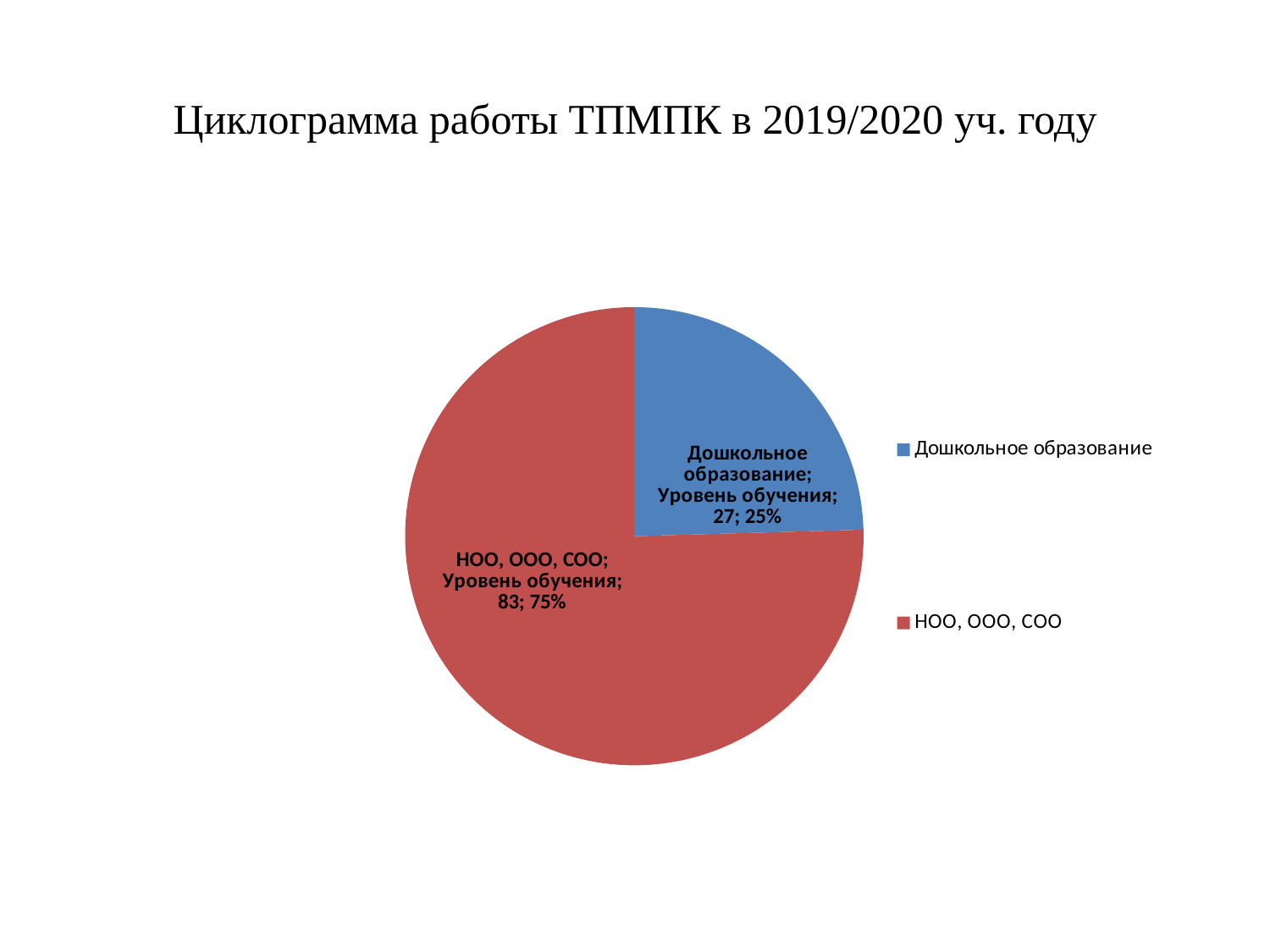
What kind of chart is shown on the slide? pie chart Which category has the largest slice? НОО, ООО, СОО What is the value for НОО, ООО, СОО? 83 What share of the pie does Дошкольное образование take? 25% What colour is the slice for Дошкольное образование? blue What is the total of the two values shown in the pie chart? 110 Which category has the smallest slice? Дошкольное образование What is the difference between the values for НОО, ООО, СОО and Дошкольное образование? 56 What share of the pie does НОО, ООО, СОО take? 75% Which is larger, the value for Дошкольное образование or the value for НОО, ООО, СОО? НОО, ООО, СОО What is the value for Дошкольное образование? 27 How many slices does the pie chart have? 2